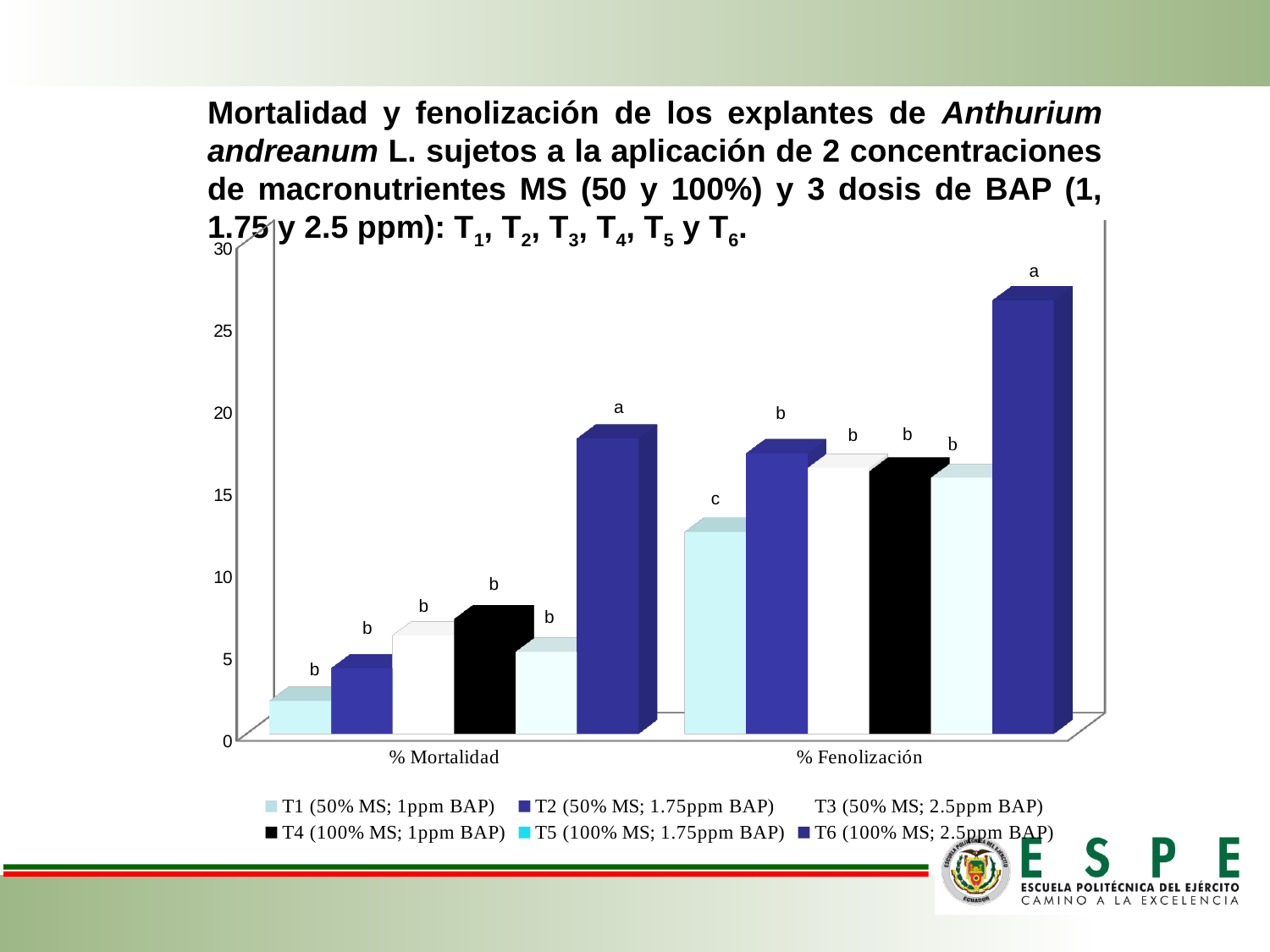
How many series does the legend list? 6 What kind of chart is shown on the slide? bar chart Which treatment has the lowest value in the % Mortalidad category? T1 (50% MS; 1ppm BAP) How many categories are shown on the x axis? 2 Is the value for T6 in % Mortalidad greater or less than 15? greater Is the value for T1 in % Mortalidad greater or less than 5? less Which treatment has the lowest value in the % Fenolización category? T1 (50% MS; 1ppm BAP) Is the value for T6 in % Fenolización greater or less than 25? greater Which treatment has the highest value in the % Fenolización category? T6 (100% MS; 2.5ppm BAP) Which treatment has the highest value in the % Mortalidad category? T6 (100% MS; 2.5ppm BAP) What letter is printed above the T1 bar in the % Fenolización category? c Which is larger: the value for T4 or the value for T1 in % Mortalidad? T4